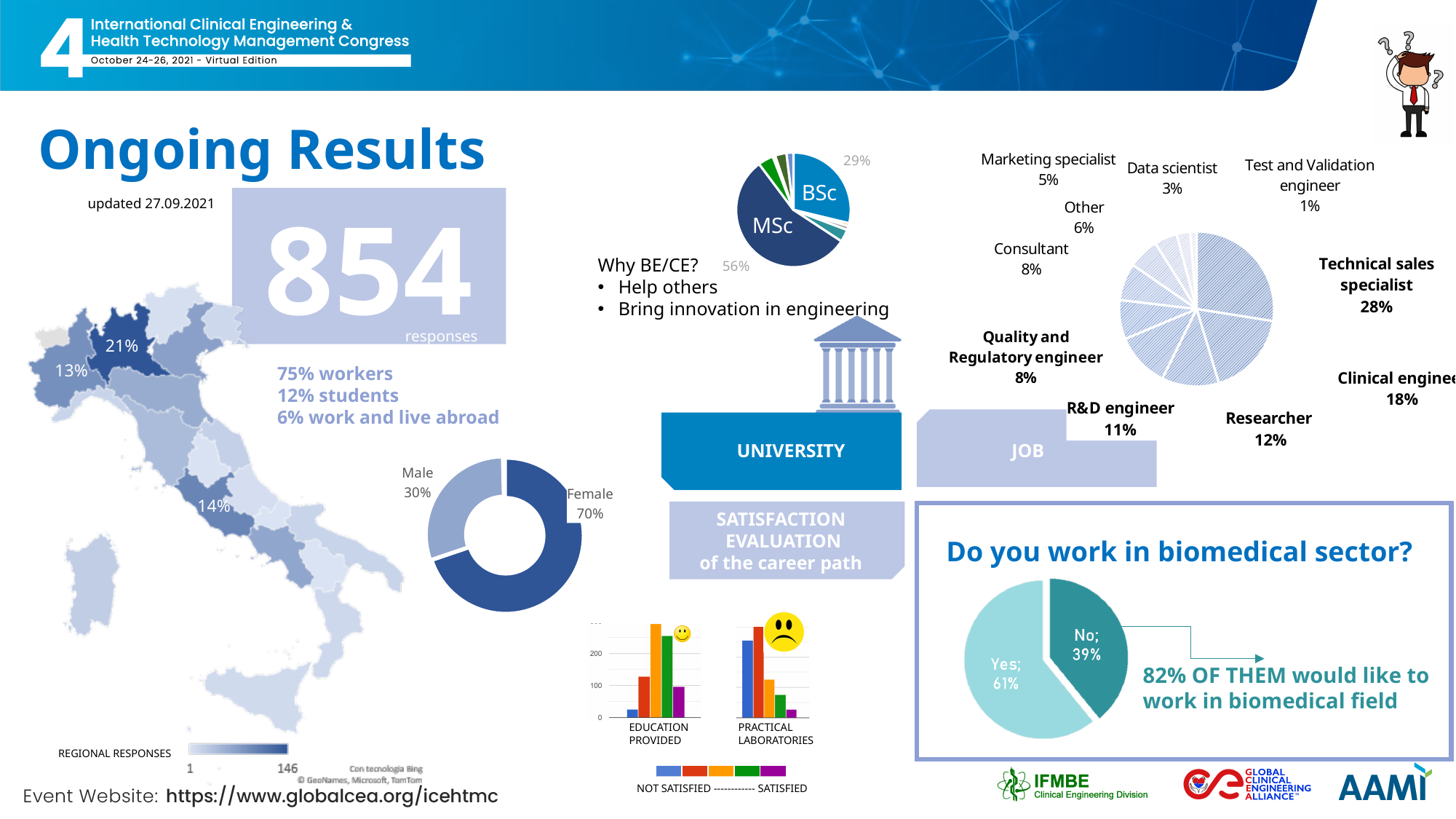
In the job pie chart, what is the percentage for Clinical engineer? 18% In the 'Do you work in biomedical sector?' pie chart, what percentage answered Yes? 61% In the Male/Female donut chart, what is the share for Female? 70% In the 'Do you work in biomedical sector?' pie chart, what is the difference between the Yes and No shares? 22% In the job pie chart, how many job categories are shown? 10 In the job pie chart, which job category has the lowest percentage? Test and Validation engineer In the Male/Female donut chart, which category is larger, Male or Female? Female In the job pie chart, which job category has the highest percentage? Technical sales specialist In the job pie chart, what is the difference between Researcher and R&D engineer? 1% In the 'Do you work in biomedical sector?' pie chart, what percentage answered No? 39% In the BSc/MSc pie chart, what is the percentage for MSc? 56% What kind of chart is used for 'Do you work in biomedical sector?'? Pie chart